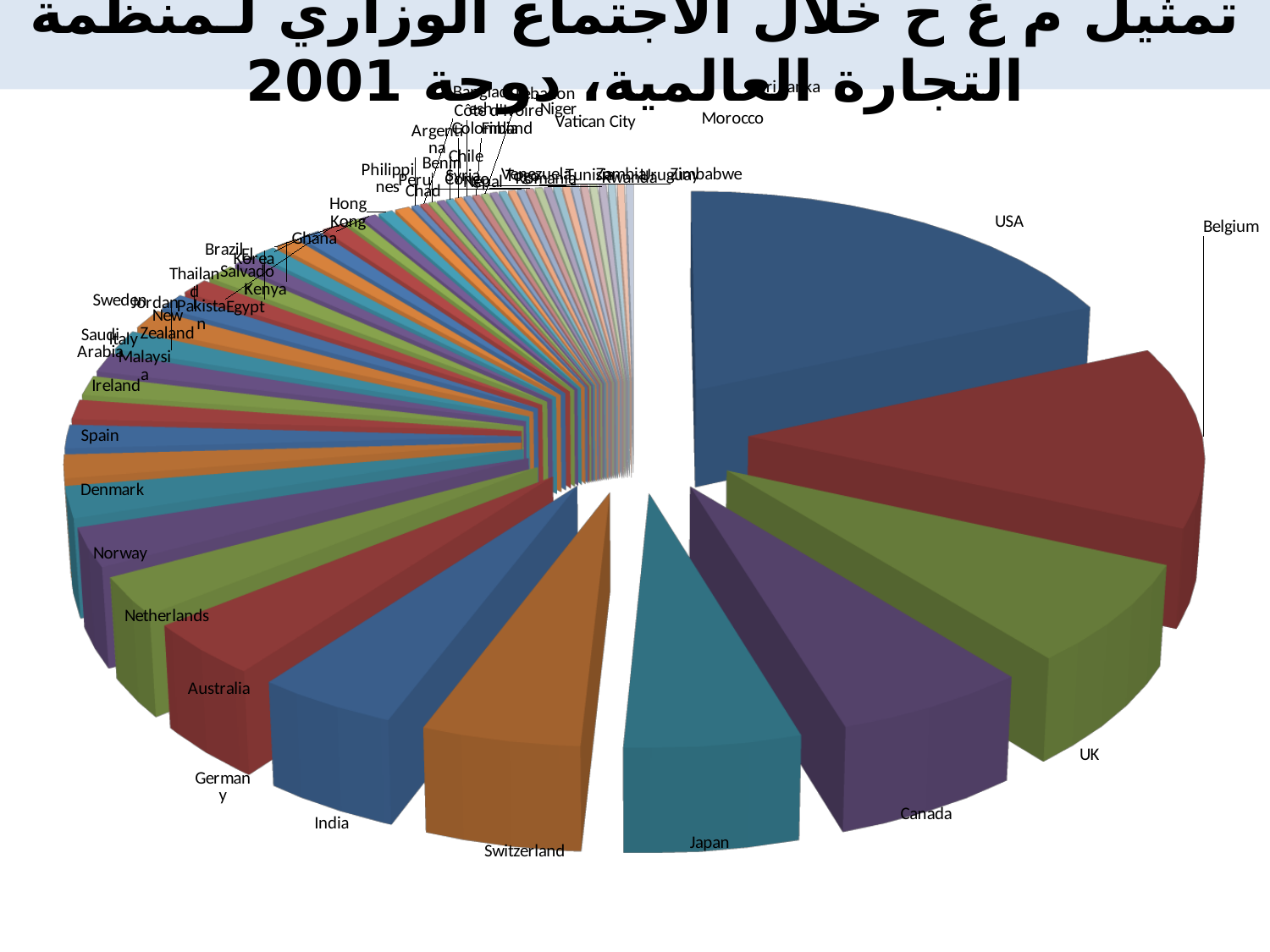
Which slice is larger, Germany or Australia? Germany Which year is mentioned in the chart title? 2001 Which slice is larger, USA or Japan? USA Which slice is larger, Belgium or Canada? Belgium Which country has the largest slice of the pie? USA Which city is mentioned in the chart title? Doha (دوحة) What kind of chart is shown on the slide? pie chart